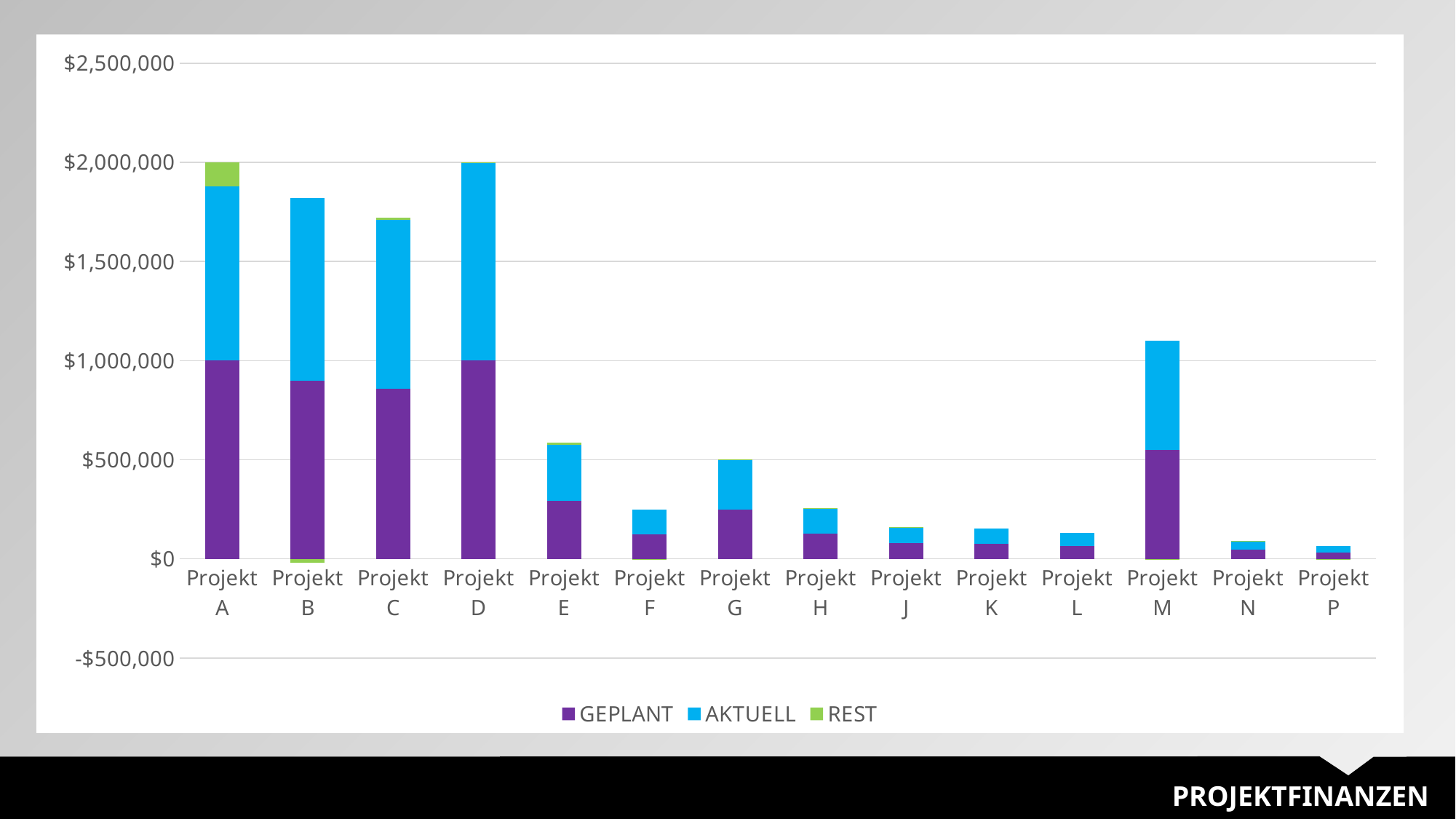
Is the total for Projekt F greater or less than $500,000? less What kind of chart is shown on the slide? Stacked bar chart Which has the larger total, Projekt M or Projekt E? Projekt M What is the GEPLANT value for Projekt D? $1,000,000 What is the GEPLANT value for Projekt A? $1,000,000 Which has the larger total, Projekt B or Projekt C? Projekt B What are the three series named in the legend? GEPLANT, AKTUELL, REST Is the total for Projekt B greater or less than $1,500,000? greater How many projects are shown on the x axis? 14 Is the total for Projekt M greater or less than $1,000,000? greater How many series does the legend list? 3